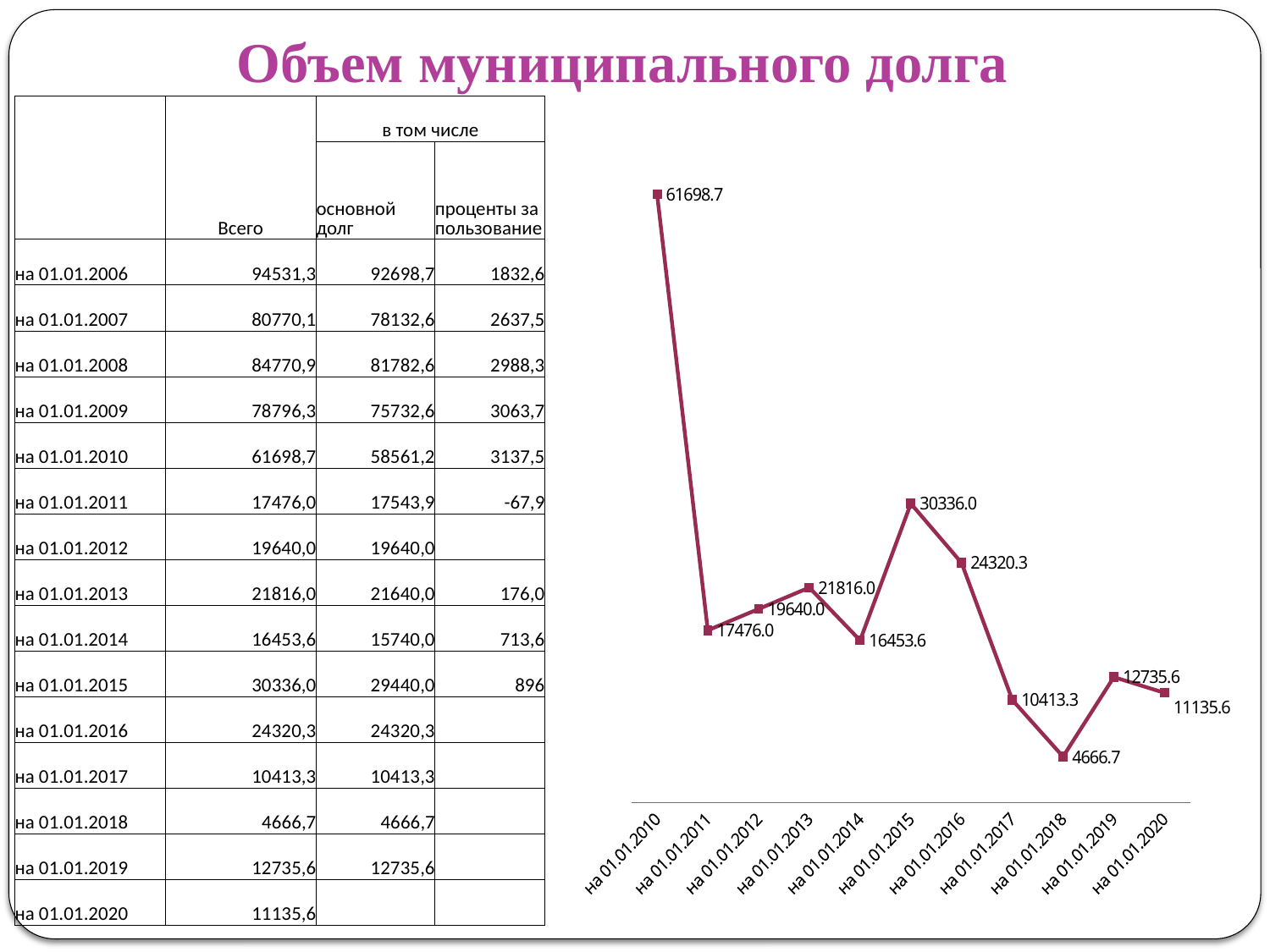
What is the value plotted for на 01.01.2015? 30336.0 Which is larger, the value for на 01.01.2013 or the value for на 01.01.2014? на 01.01.2013 What is the value plotted for на 01.01.2020? 11135.6 Which date has the highest value on the chart? на 01.01.2010 Which date has the lowest value on the chart? на 01.01.2018 What is the difference between the values for на 01.01.2015 and на 01.01.2016? 6015.7 What type of chart is shown on the slide? line chart Does the value rise or fall from на 01.01.2010 to на 01.01.2011? fall What is the difference between the values for на 01.01.2019 and на 01.01.2020? 1600.0 How many data points are plotted on the chart? 11 What is the value plotted for на 01.01.2018? 4666.7 What is the value plotted for на 01.01.2010? 61698.7